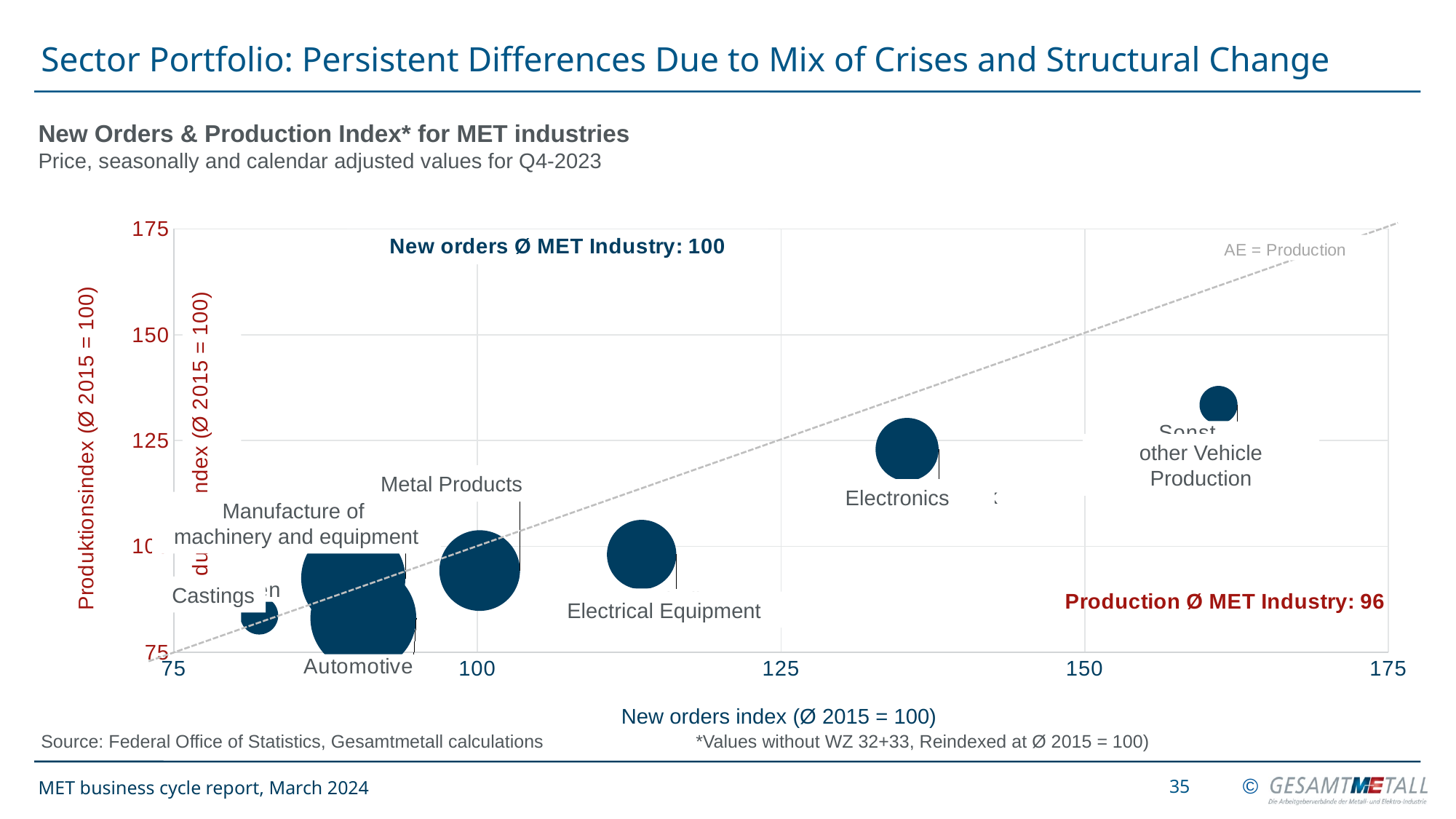
What is the production average for the MET industry stated on the chart? 96 Is the new orders index for Electronics greater or less than 125? greater Which sector has the lowest new orders index? Castings Is the production index for other Vehicle Production greater or less than 125? greater Which has the higher new orders index, Electronics or Metal Products? Electronics What kind of chart is shown on the slide? bubble chart Which sector has the highest production index? other Vehicle Production What is the new orders average for the MET industry stated on the chart? 100 Is the new orders index for Electrical Equipment greater or less than 100? greater Which has the higher production index, Metal Products or Automotive? Metal Products Which sector has the highest new orders index? other Vehicle Production How many sectors are plotted as bubbles in the chart? 7